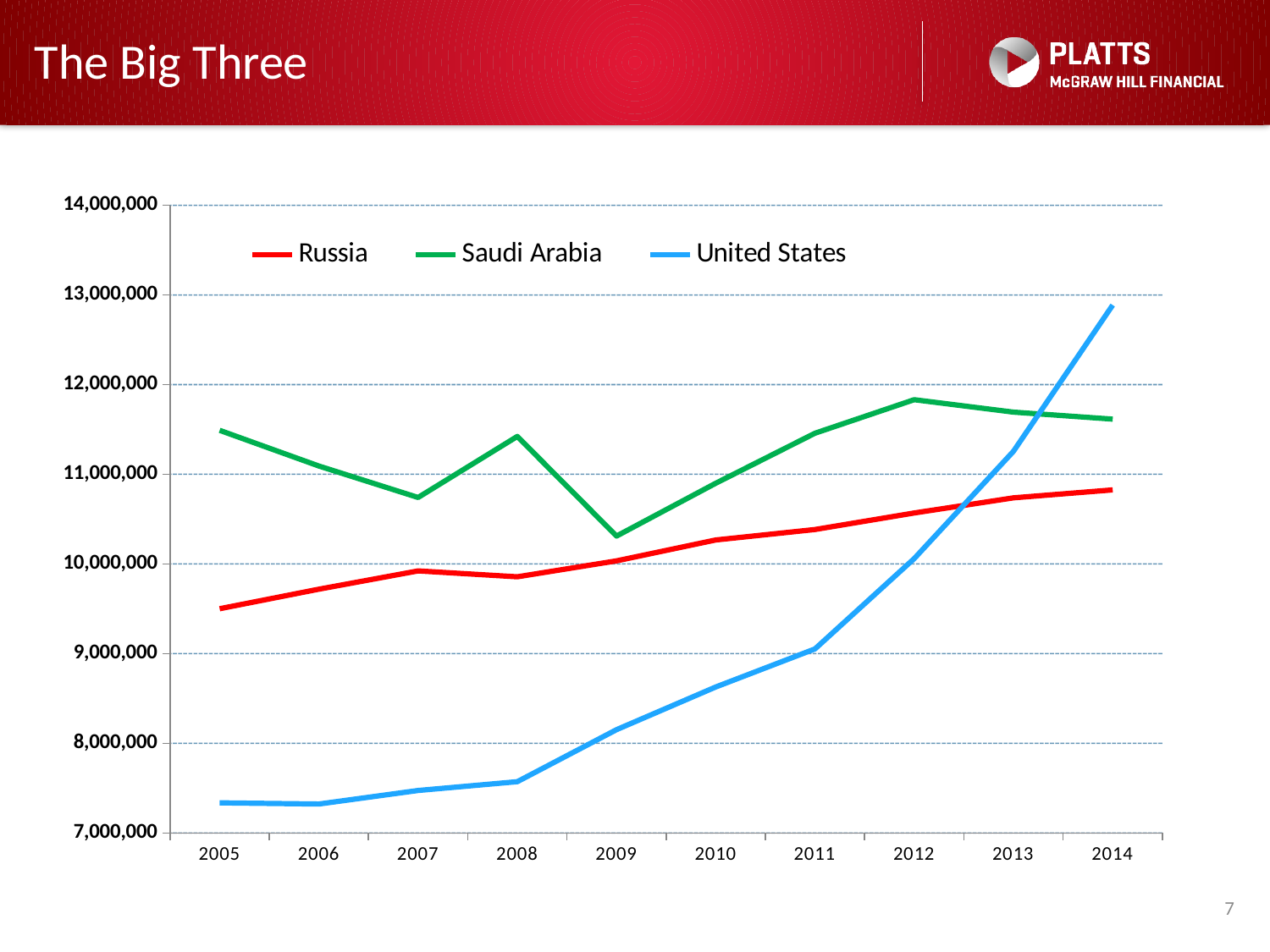
Is the value for United States in 2014 greater or less than 12,000,000? greater In which year does Saudi Arabia reach its lowest value? 2009 Is the value for Russia in 2005 greater or less than 10,000,000? less Does the United States line generally rise or fall from 2005 to 2014? Rise Which series has the lowest value in 2005? United States In 2010, which is larger: the value for Russia or the value for United States? Russia How many series does the legend list? 3 How many years are shown along the x axis? 10 What kind of chart is shown on the slide? Line chart Is the value for United States in 2005 greater or less than 8,000,000? less Which series has the highest value in 2014? United States